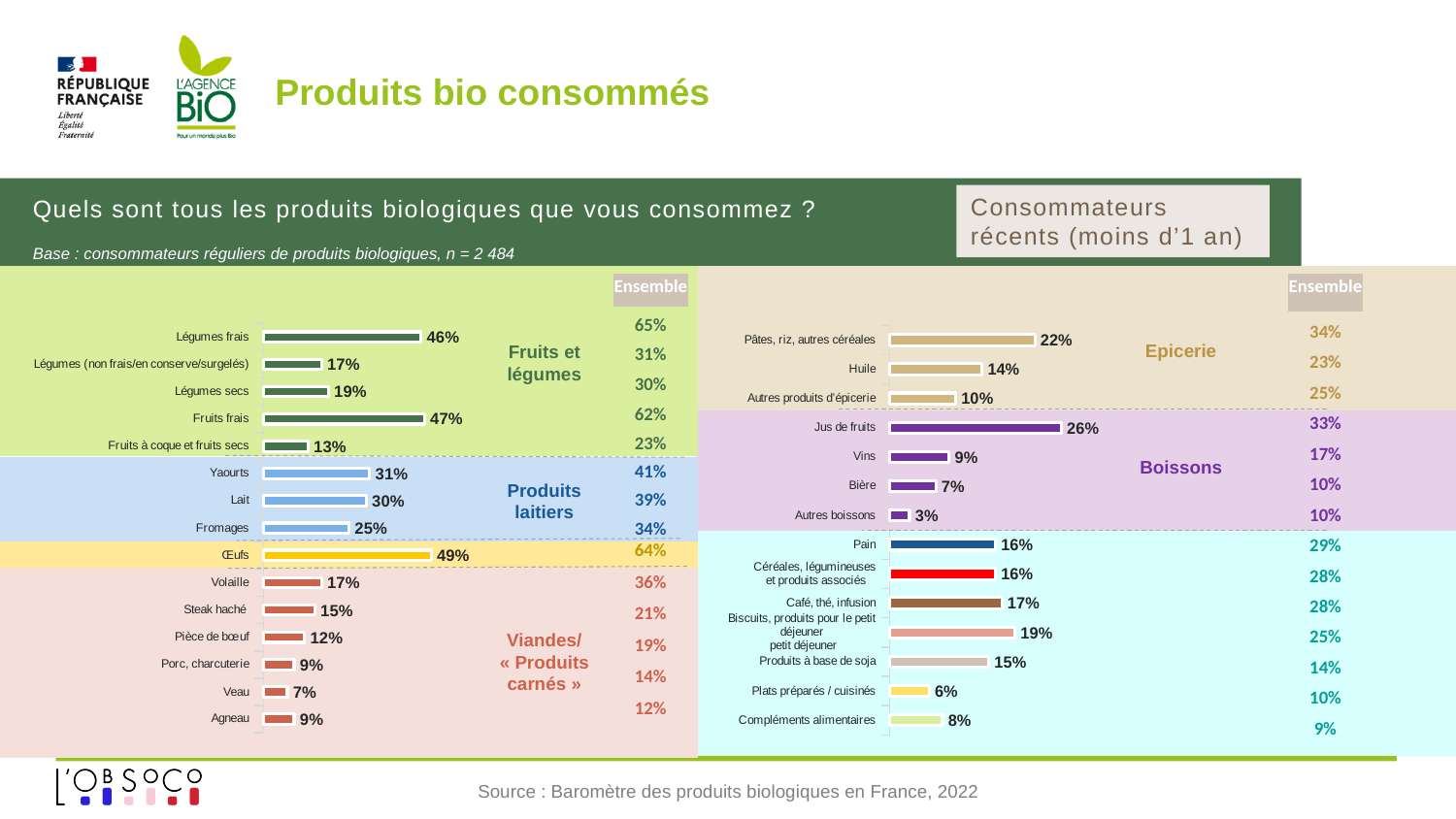
What type of chart is used on the left side of the slide? Bar chart On the left chart, which category has the lowest value? Veau On the right chart, what is the value for Jus de fruits? 26% On the right chart, which category has the highest value? Jus de fruits On the left chart, what is the value for Œufs? 49% On the right chart, which category has the lowest value? Autres boissons On the left chart, what is the value for Légumes frais? 46% On the left chart, what is the difference between Fruits frais and Fruits à coque et fruits secs? 34% On the right chart, which is larger, Pâtes, riz, autres céréales or Huile? Pâtes, riz, autres céréales On the right chart, what is the value for Biscuits, produits pour le petit déjeuner? 19% On the left chart, which category has the highest value? Œufs On the right chart, how many categories are plotted? 14